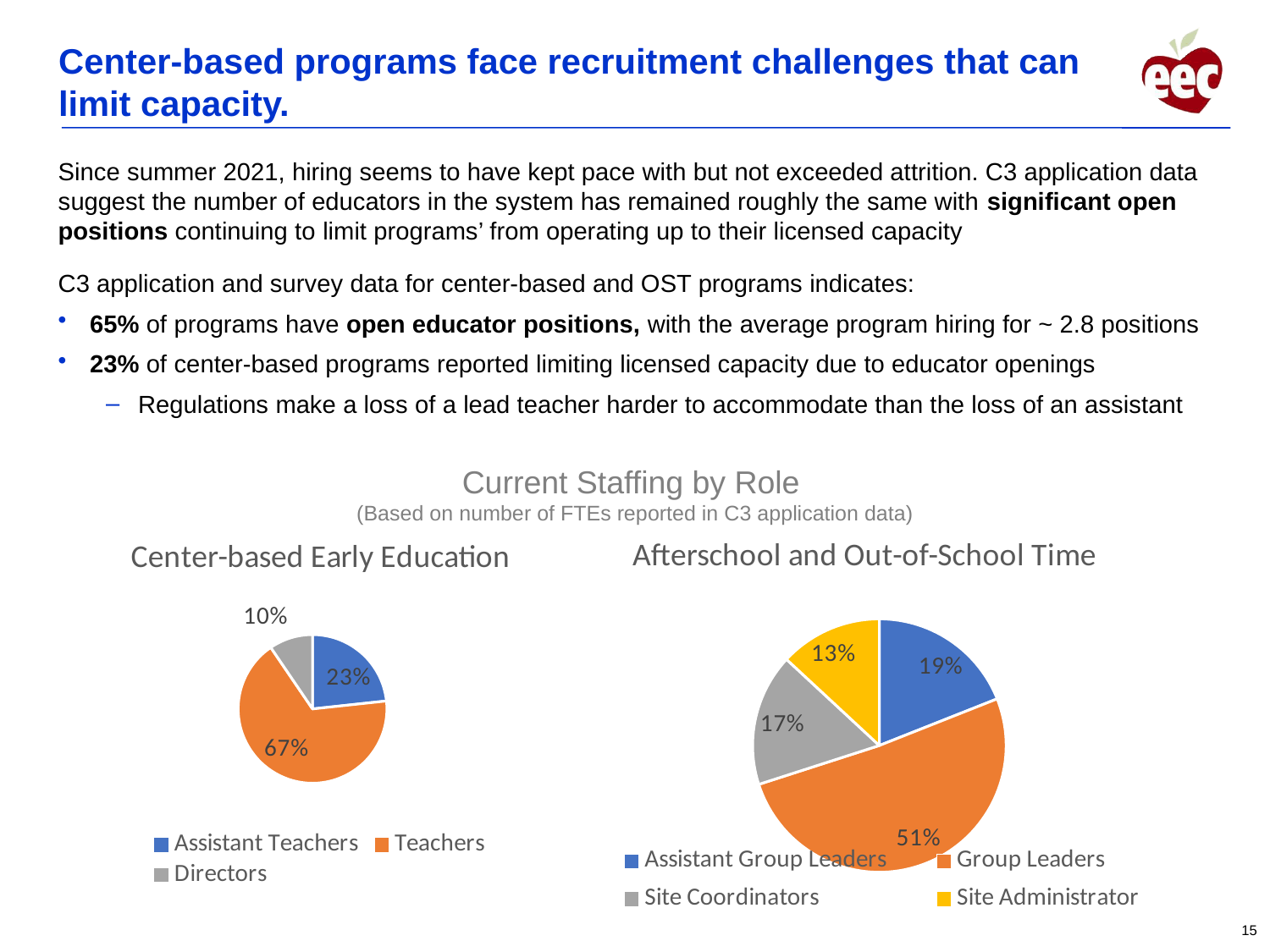
In the Afterschool and Out-of-School Time chart, which role has the smallest share? Site Administrator What type of chart is the Center-based Early Education chart? Pie chart In the Center-based Early Education chart, which role has the largest share? Teachers In the Afterschool and Out-of-School Time chart, which is larger: Assistant Group Leaders or Site Coordinators? Assistant Group Leaders How many slices does the Afterschool and Out-of-School Time chart have? 4 In the Afterschool and Out-of-School Time chart, what share of staffing is Site Administrator? 13% In the Center-based Early Education chart, what share of staffing is Directors? 10% In the Center-based Early Education chart, what share of staffing is Teachers? 67% In the Afterschool and Out-of-School Time chart, what share of staffing is Group Leaders? 51% What is the overall title shown above the two charts? Current Staffing by Role In the Center-based Early Education chart, what is the difference in percentage points between Teachers and Assistant Teachers? 44 How many entries does the legend of the Center-based Early Education chart list? 3